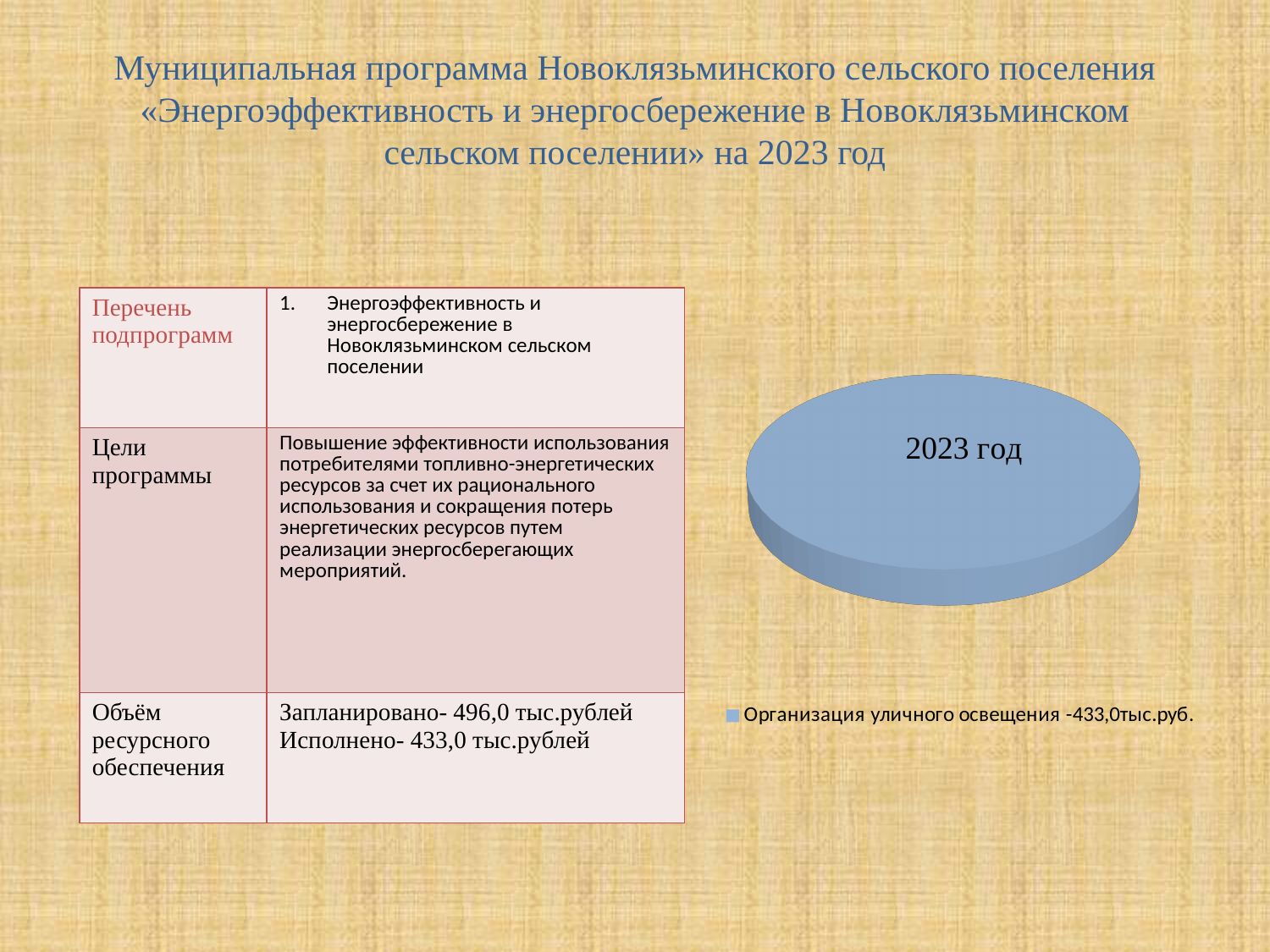
What colour is the single slice of the pie chart? blue How many slices does the pie chart contain? 1 What share of the pie chart does "Организация уличного освещения" take up? 100% What value is given in the legend for "Организация уличного освещения"? 433,0тыс.руб. How many entries does the legend of the pie chart list? 1 What is the title of the pie chart? 2023 год What kind of chart is shown on the right side of the slide? pie chart